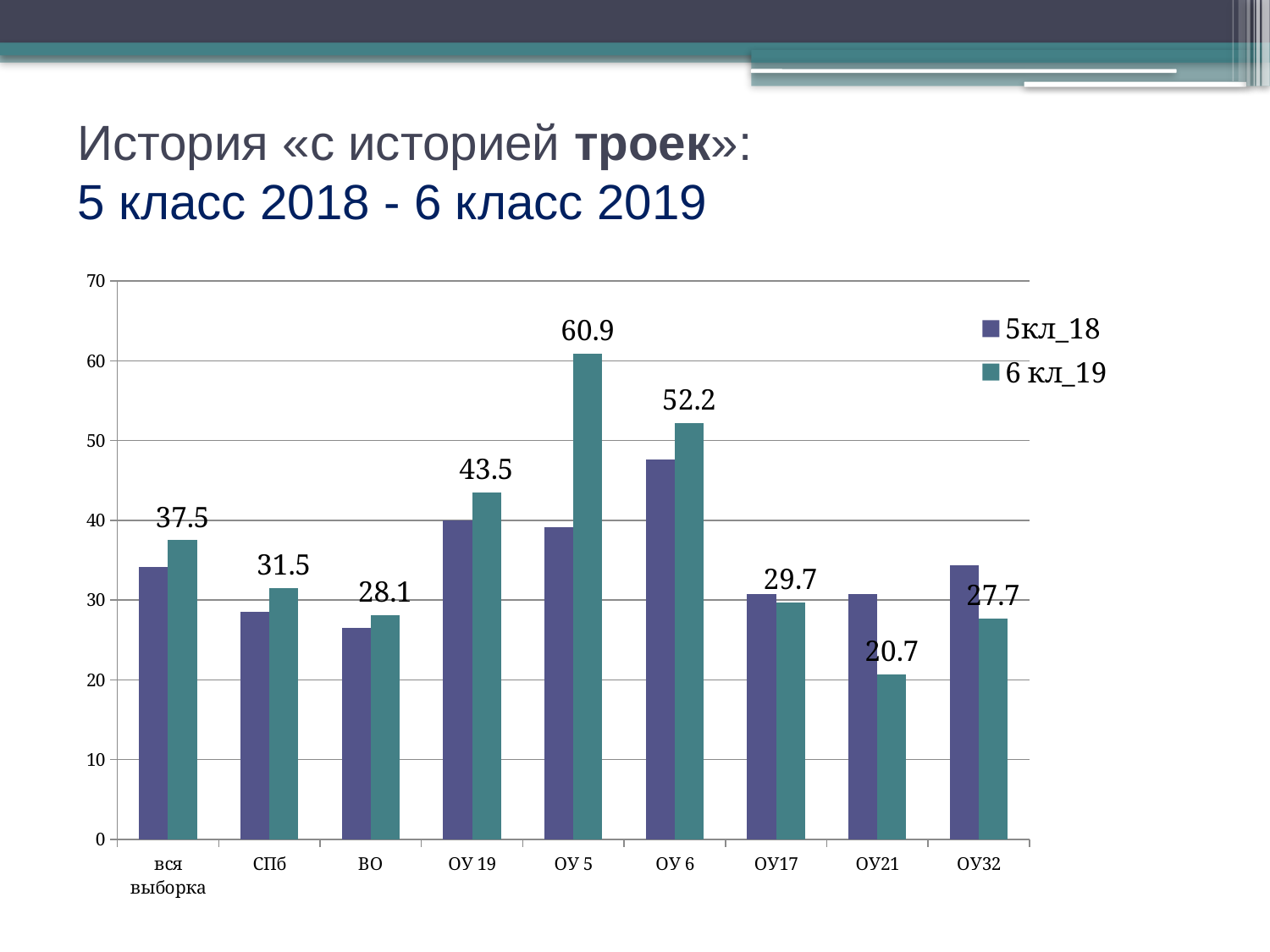
Is the 5кл_18 value for ОУ 6 greater or less than 40? greater How many series does the legend list? 2 What is the value of the 6 кл_19 series for ОУ21? 20.7 What kind of chart is shown on the slide? bar chart How many categories are shown on the x axis? 9 Which category has the highest value in the 6 кл_19 series? ОУ 5 What is the difference between the 6 кл_19 values for ОУ 5 and ОУ 6? 8.7 For ОУ32, which series has the larger value, 5кл_18 or 6 кл_19? 5кл_18 Which category has the lowest value in the 6 кл_19 series? ОУ21 What is the value of the 6 кл_19 series for вся выборка? 37.5 Is the 5кл_18 value for ВО greater or less than 30? less What is the value of the 6 кл_19 series for ОУ 5? 60.9